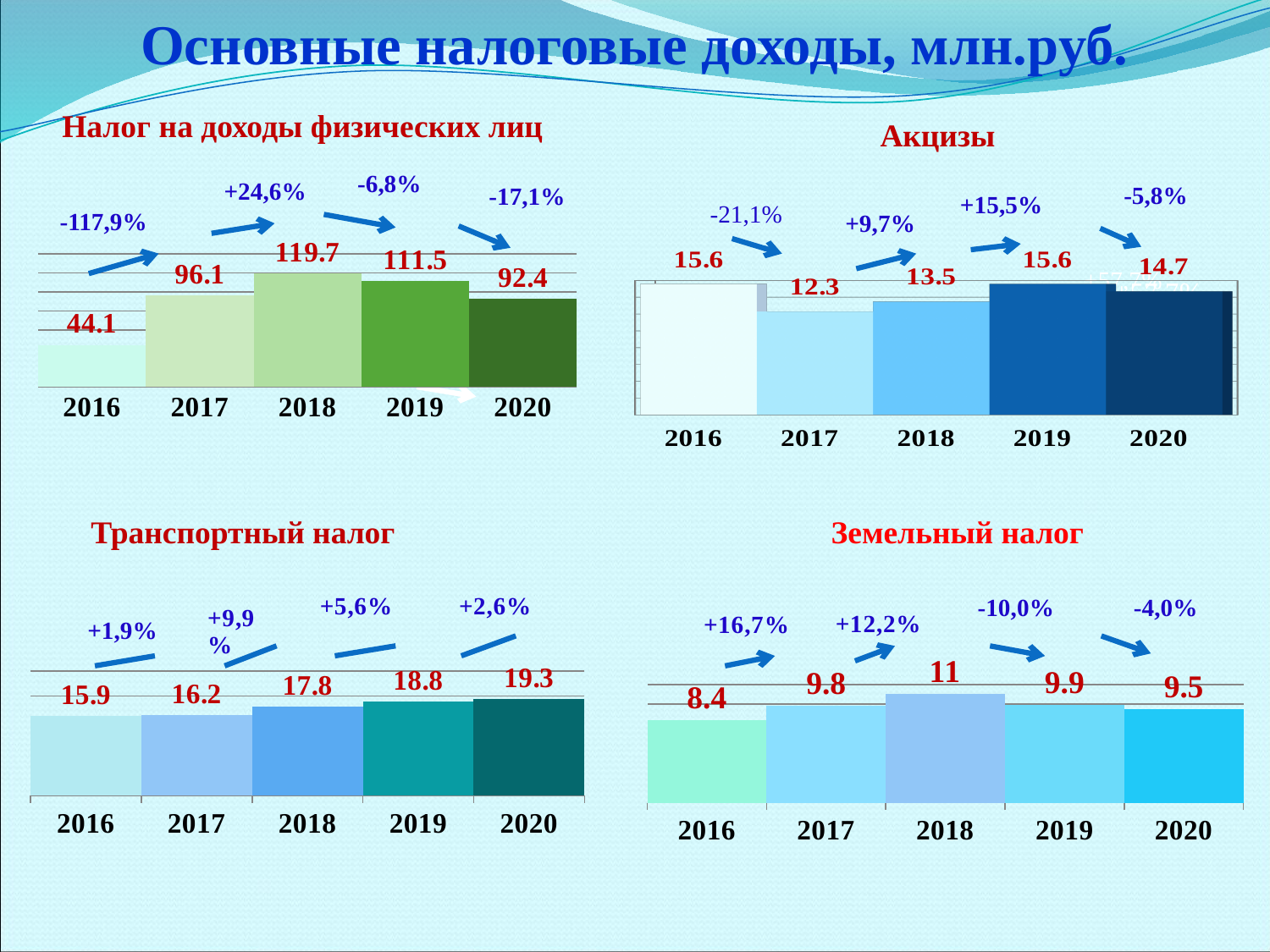
In the chart titled "Акцизы", which is larger, the value for 2018 or the value for 2020? 2020 In the chart titled "Транспортный налог", what is the difference between the values for 2018 and 2016? 1.9 In the chart titled "Налог на доходы физических лиц", what is the difference between the values for 2019 and 2020? 19.1 In the chart titled "Земельный налог", which year has the highest value? 2018 What kind of chart is the one titled "Земельный налог"? bar chart In the chart titled "Транспортный налог", what is the value for 2020? 19.3 In the chart titled "Налог на доходы физических лиц", what is the value for 2018? 119.7 In the chart titled "Транспортный налог", do the values rise or fall from 2016 to 2020? rise In the chart titled "Акцизы", how many years are shown? 5 In the chart titled "Налог на доходы физических лиц", which year has the lowest value? 2016 In the chart titled "Земельный налог", what is the value for 2016? 8.4 In the chart titled "Акцизы", what is the value for 2017? 12.3